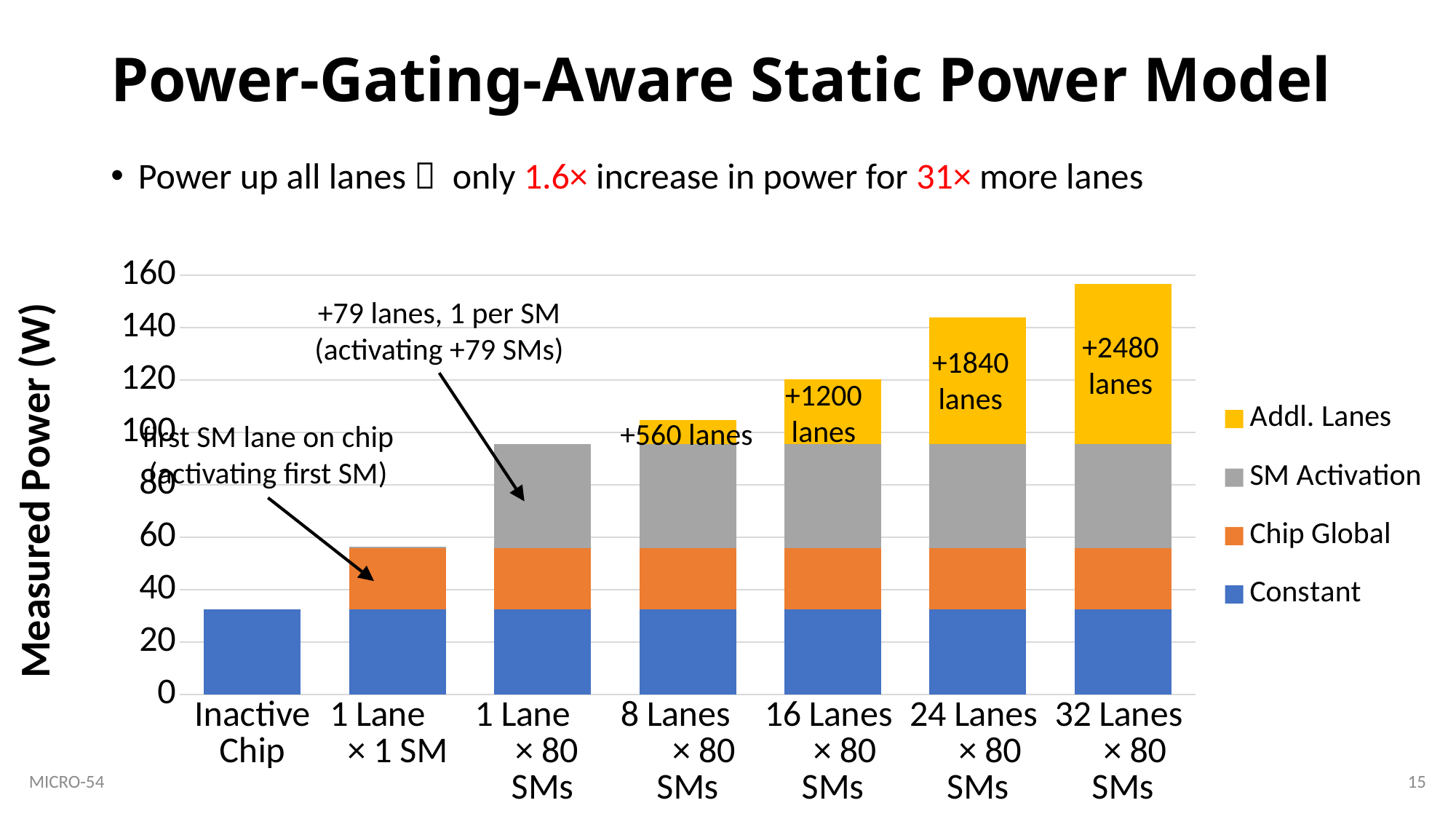
Is the total measured power for Inactive Chip greater or less than 40? less How many categories are shown along the x axis of the chart? 7 Do the total bar heights rise or fall moving from left to right along the x axis? Rise Is the total measured power for 1 Lane × 80 SMs greater or less than 80? greater Which has the larger total measured power, 8 Lanes × 80 SMs or 16 Lanes × 80 SMs? 16 Lanes × 80 SMs Is the total measured power for 32 Lanes × 80 SMs greater or less than 140? greater Which category has the highest total measured power? 32 Lanes × 80 SMs What kind of chart is shown on the slide? Stacked bar chart What is the label of the y axis? Measured Power (W) How many series does the chart's legend list? 4 Which category has the lowest total measured power? Inactive Chip